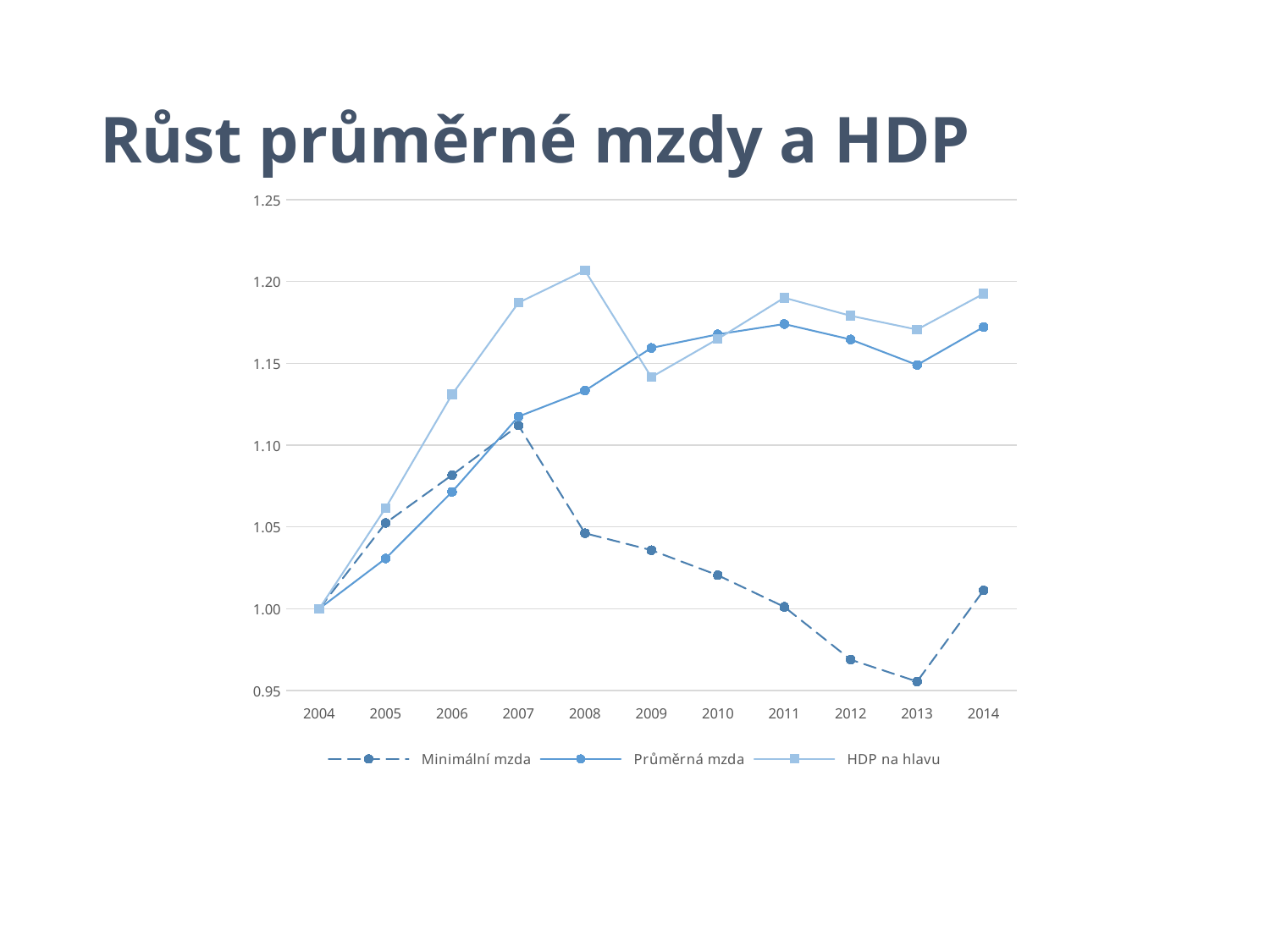
What is the value of Průměrná mzda in 2004? 1.00 Is the value for Průměrná mzda in 2011 greater or less than 1.15? greater In which year does Minimální mzda reach its lowest value? 2013 Does Minimální mzda rise or fall from 2007 to 2013? fall In which year does HDP na hlavu reach its highest value? 2008 How many series does the legend list? 3 What is the title of the chart? Růst průměrné mzdy a HDP Is the value for HDP na hlavu in 2008 greater or less than 1.20? greater What kind of chart is shown on the slide? line chart In 2009, which is higher: Průměrná mzda or HDP na hlavu? Průměrná mzda How many years are shown on the x axis? 11 Is the value for Minimální mzda in 2013 greater or less than 1.00? less